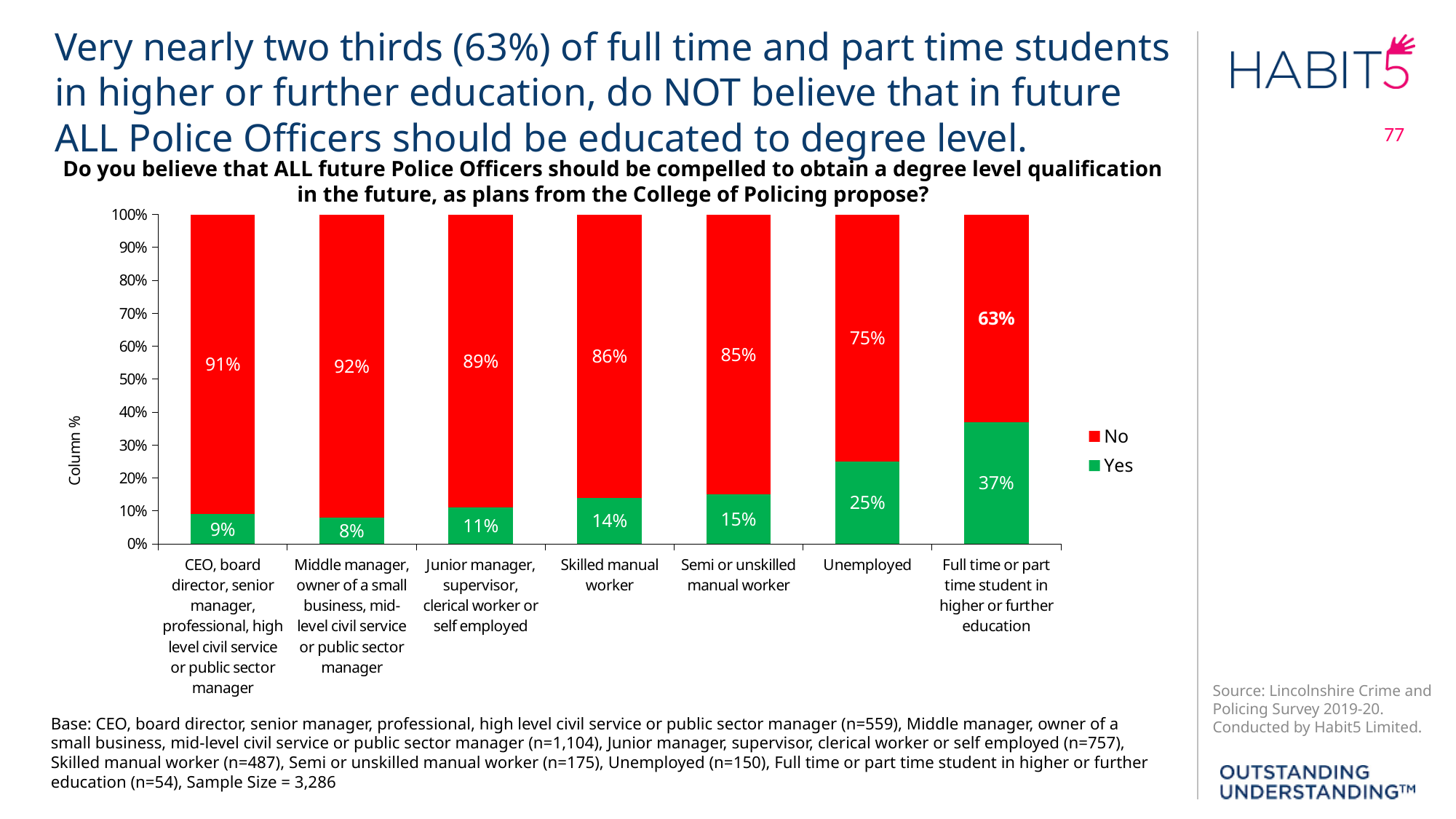
How many occupation categories are shown on the x axis? 7 Does the "Yes" percentage rise or fall moving from left to right across the categories? Rises What type of chart is shown? Stacked bar chart How many series does the legend list? 2 Which category has the highest "No" percentage? Middle manager, owner of a small business, mid-level civil service or public sector manager What is the difference between the "No" percentage for Unemployed and for Full time or part time students in higher or further education? 12% What is the "Yes" value for Full time or part time students in higher or further education? 37% Which colour represents the "No" responses? Red Which category has the lowest "Yes" percentage? Middle manager, owner of a small business, mid-level civil service or public sector manager Which is larger: the "Yes" value for Semi or unskilled manual workers or for Skilled manual workers? Semi or unskilled manual worker What percentage of Unemployed respondents answered "No"? 75% What percentage of Skilled manual workers answered "Yes"? 14%